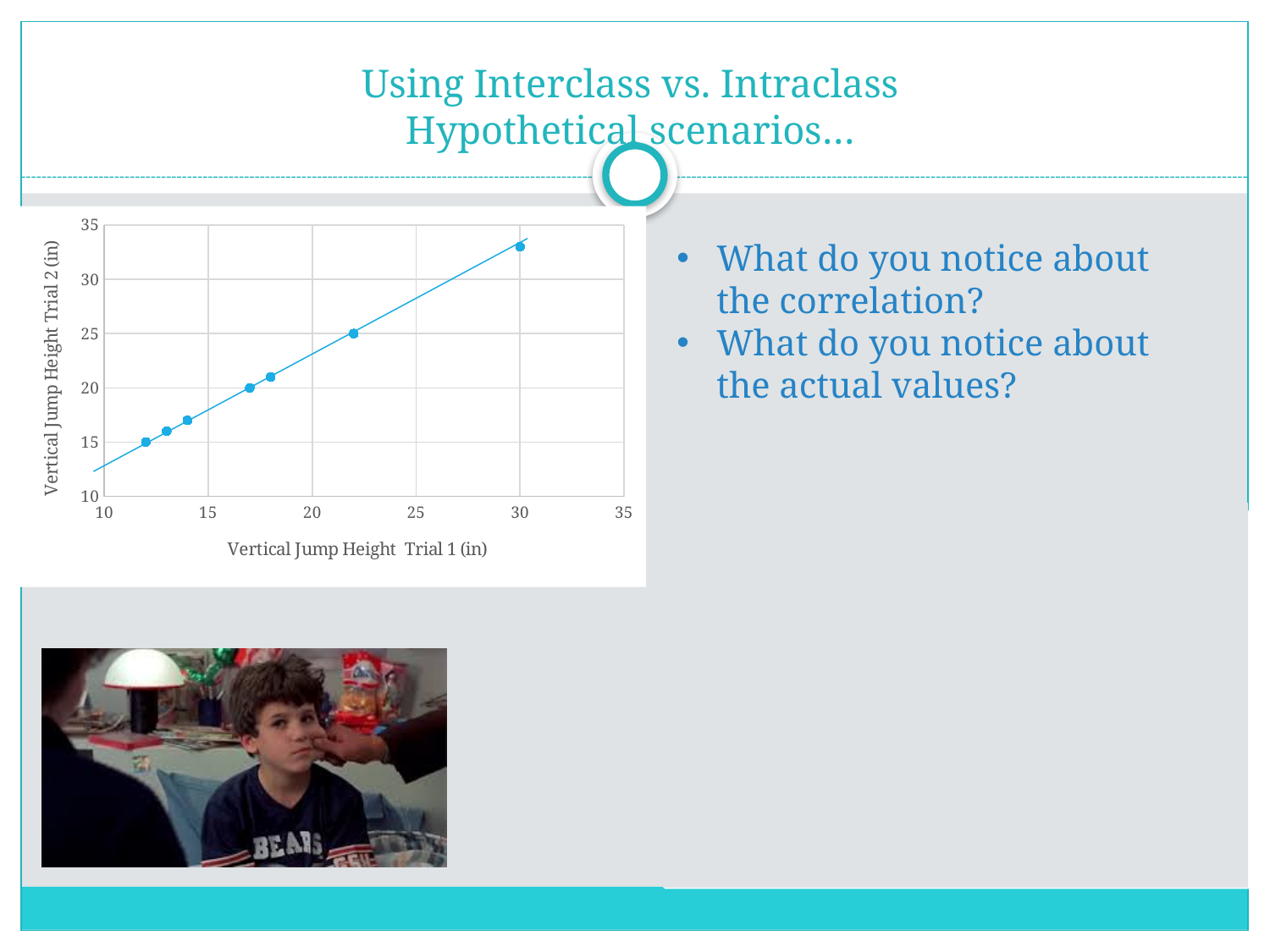
How many data points have a Trial 1 value greater than 25? 1 Is the Trial 2 value of the rightmost data point greater or less than 30? greater What is the Trial 1 value of the data point with the highest Trial 2 value? 30 What is the maximum value shown on the y axis? 35 Is the Trial 2 value of the leftmost data point greater or less than 20? less What kind of chart is shown on the slide? Scatter plot What is the label of the y axis? Vertical Jump Height Trial 2 (in) As Vertical Jump Height Trial 1 increases along the x axis, do the Trial 2 values rise or fall? Rise Is the Trial 1 value of the lowest data point greater or less than 15? less What is the label of the x axis? Vertical Jump Height Trial 1 (in) Which data point has a larger Trial 2 value: the one at Trial 1 = 30 or the one at Trial 1 = 22? The one at Trial 1 = 30